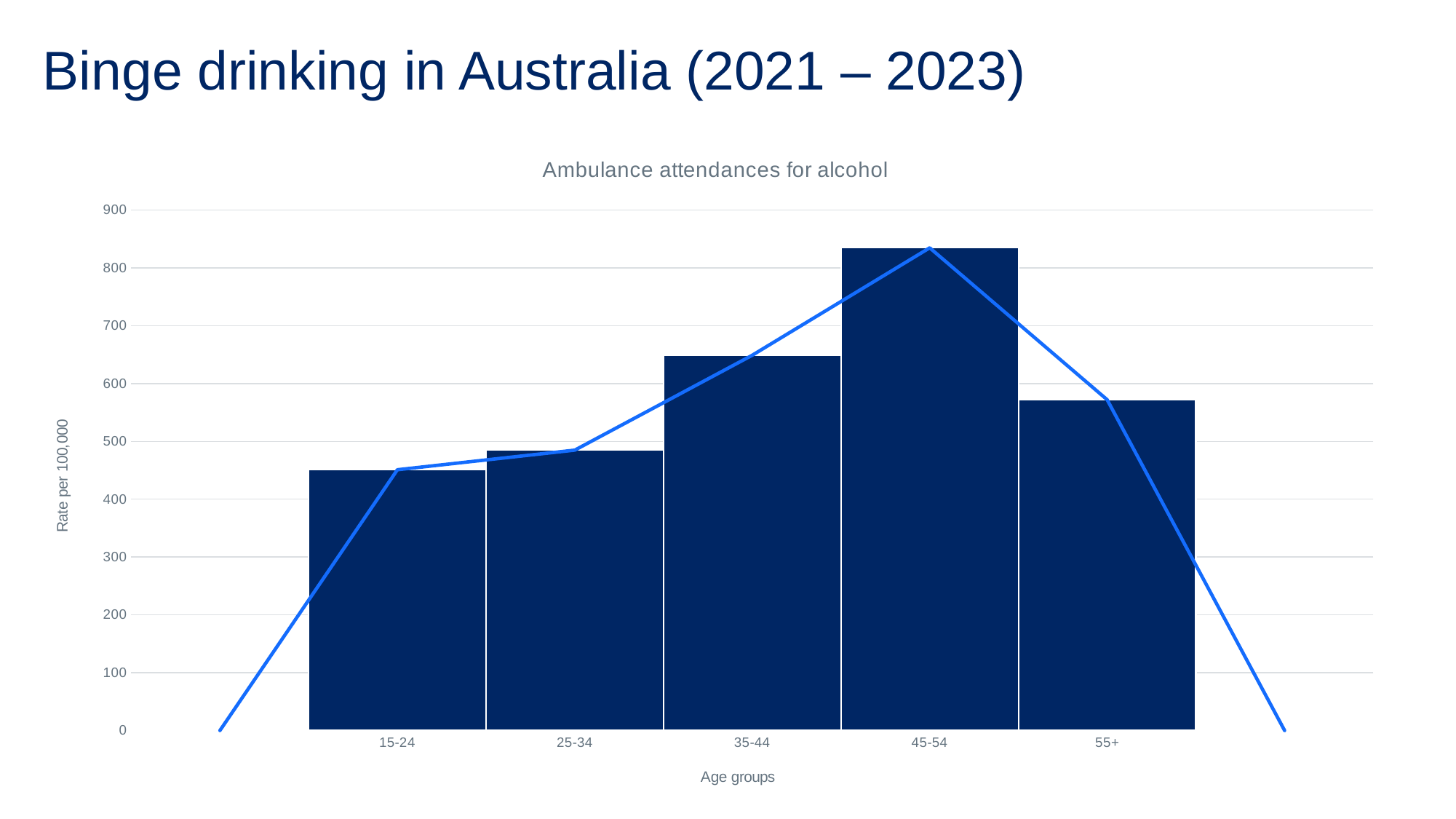
What is the title of the chart? Ambulance attendances for alcohol What type of chart is shown on the slide? Bar chart (with a line overlay) Which has a higher rate, the 35-44 age group or the 55+ age group? 35-44 How do the values change across the age groups from 15-24 to 55+? They rise up to 45-54, then fall for 55+ Is the value for the 55+ age group greater or less than 600? less Is the value for the 45-54 age group greater or less than 800? greater Is the value for the 35-44 age group greater or less than 600? greater What is the label on the y axis of the chart? Rate per 100,000 Which age group has the lowest rate of ambulance attendances for alcohol? 15-24 Which age group has the highest rate of ambulance attendances for alcohol? 45-54 How many age groups are shown on the x axis? 5